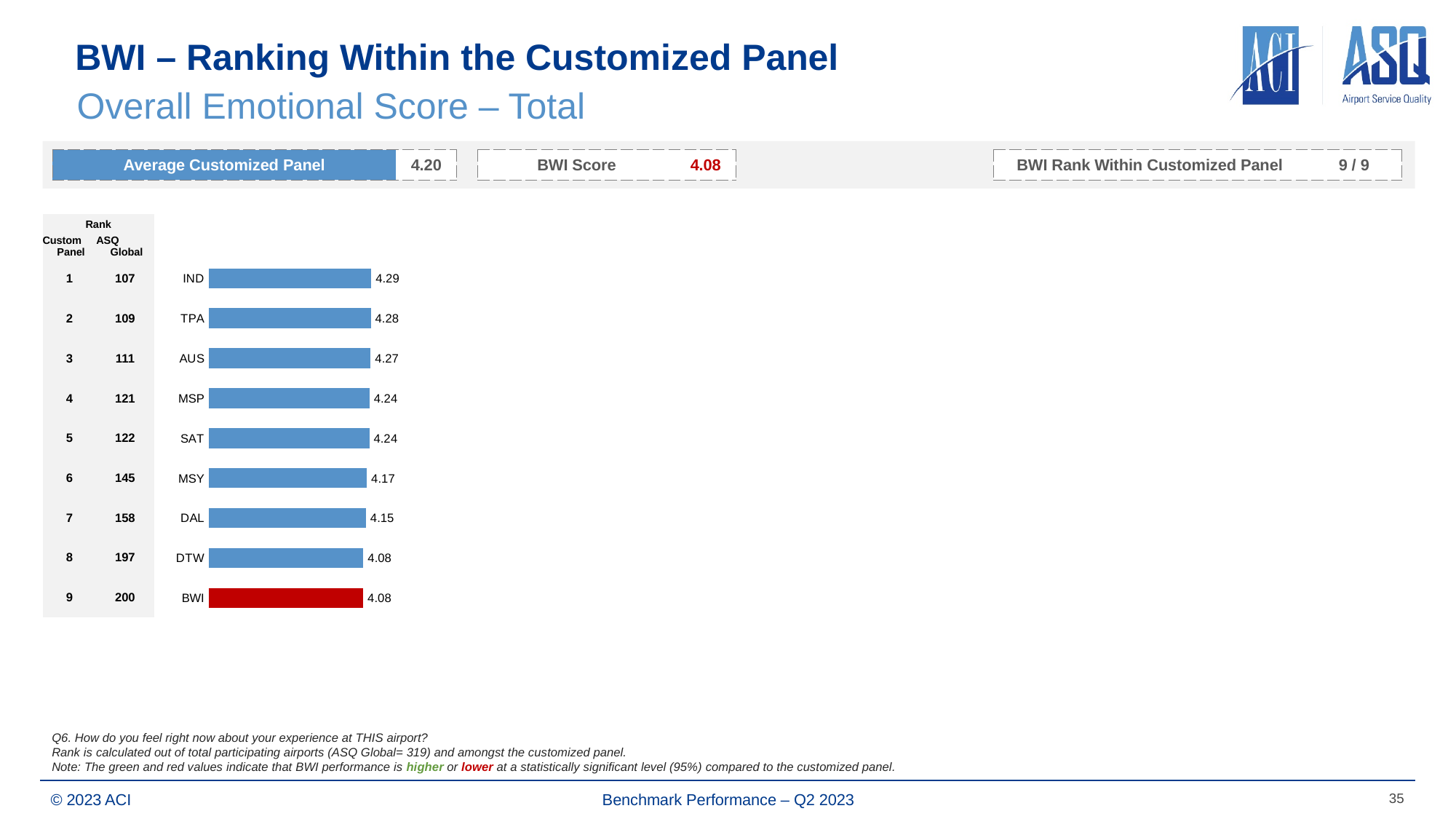
What is the difference between the scores of IND and BWI? 0.21 Which has a higher score, MSP or DAL? MSP Which airport's bar is coloured red in the chart? BWI What is the Overall Emotional Score for MSY? 4.17 What is the difference between the scores of TPA and DAL? 0.13 Which has a higher score, AUS or MSY? AUS How many airports are shown in the chart? 9 What is the Overall Emotional Score for BWI? 4.08 What is the Overall Emotional Score for IND? 4.29 What is the Average Customized Panel score shown on the slide? 4.20 What kind of chart is shown on the slide? Bar chart Which airport has the highest Overall Emotional Score in the chart? IND